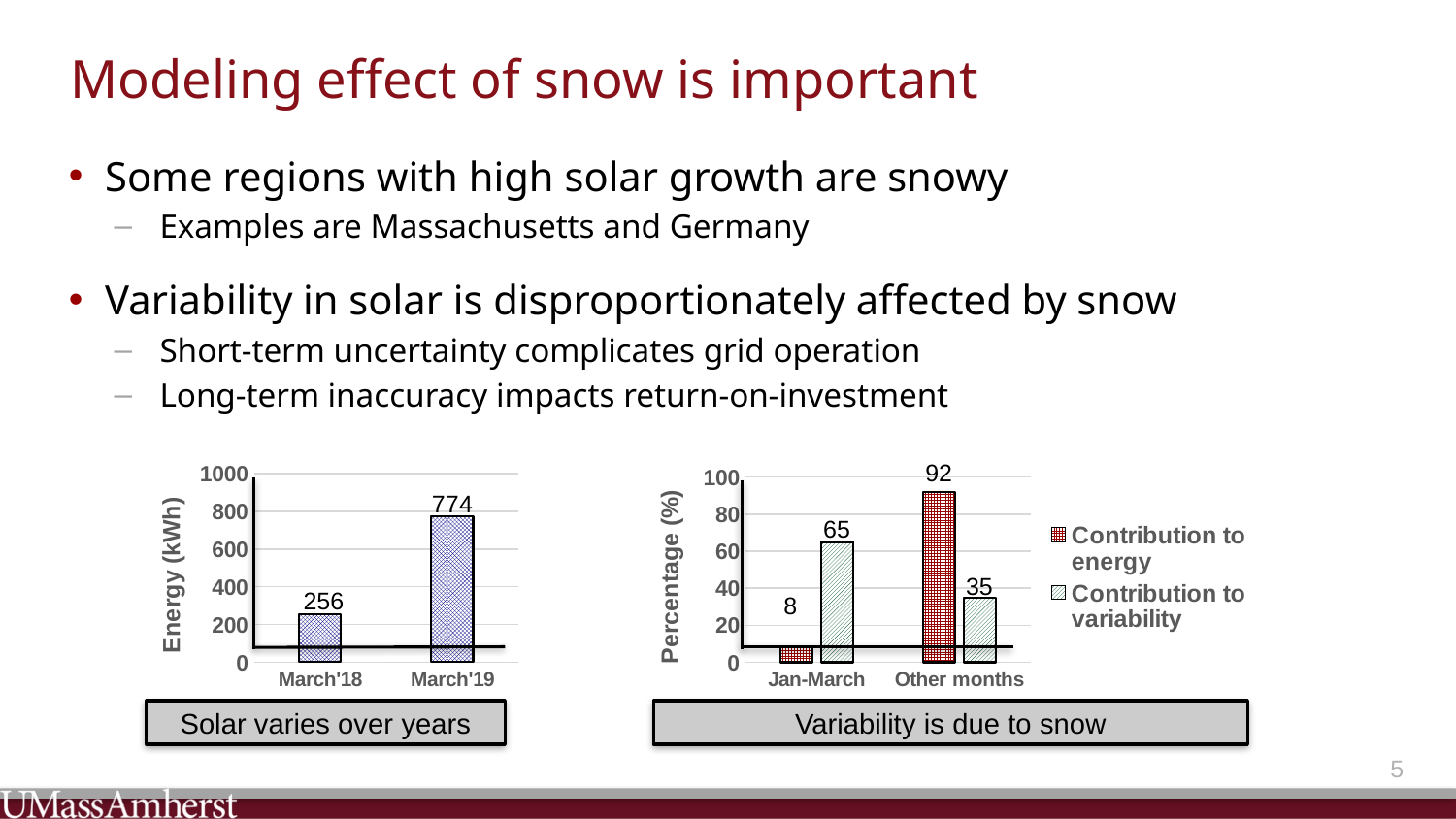
In the left chart, what is the energy value for March'19? 774 What type of chart is the right chart? Bar chart In the left chart, what is the difference in energy between March'19 and March'18? 518 In the right chart, what is the contribution to energy for Jan-March? 8 In the left chart, what is the label of the y axis? Energy (kWh) In the right chart, what is the difference between the contribution to energy and the contribution to variability for Other months? 57 In the left chart, which month has the higher energy value? March'19 In the left chart, how many categories are shown on the x axis? 2 In the left chart, what is the energy value for March'18? 256 In the right chart, what is the contribution to energy for Other months? 92 In the right chart, how many series does the legend list? 2 In the right chart, what is the contribution to variability for Jan-March? 65